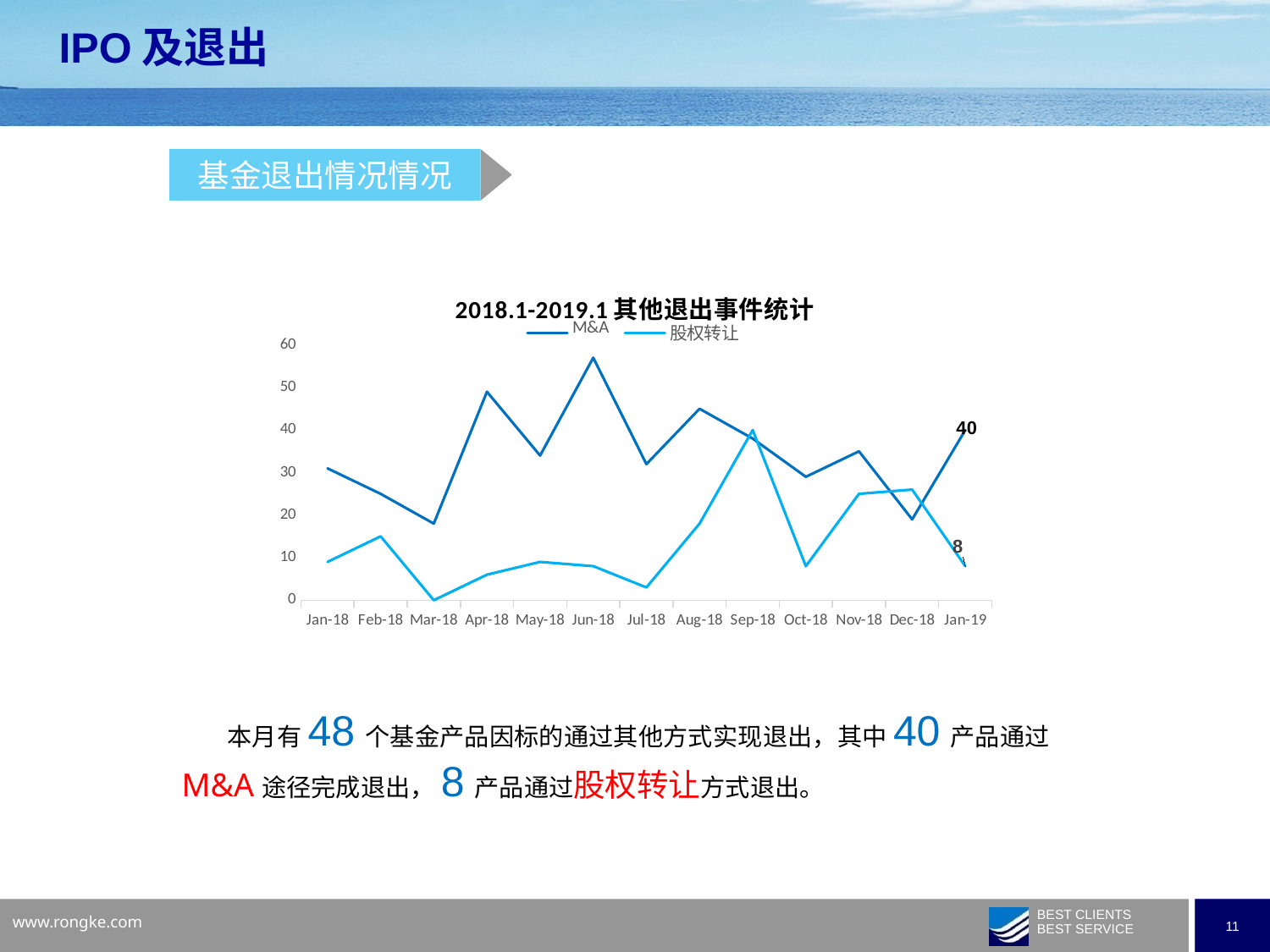
What is the difference between the M&A value and the 股权转让 value for Jan-19? 32 Is the value for 股权转让 in Jul-18 greater or less than 10? less How many series does the chart's legend list? 2 Which series has the larger value in Apr-18, M&A or 股权转让? M&A What kind of chart is shown on the slide? Line chart What is the value of the 股权转让 series for Jan-19? 8 What is the title of the chart? 2018.1-2019.1 其他退出事件统计 In which month does the M&A series reach its highest value? Jun-18 What is the value of the M&A series for Jan-19? 40 Is the value for M&A in Jun-18 greater or less than 50? greater In which month does the 股权转让 series reach its lowest value? Mar-18 How many months are shown on the x axis of the chart? 13